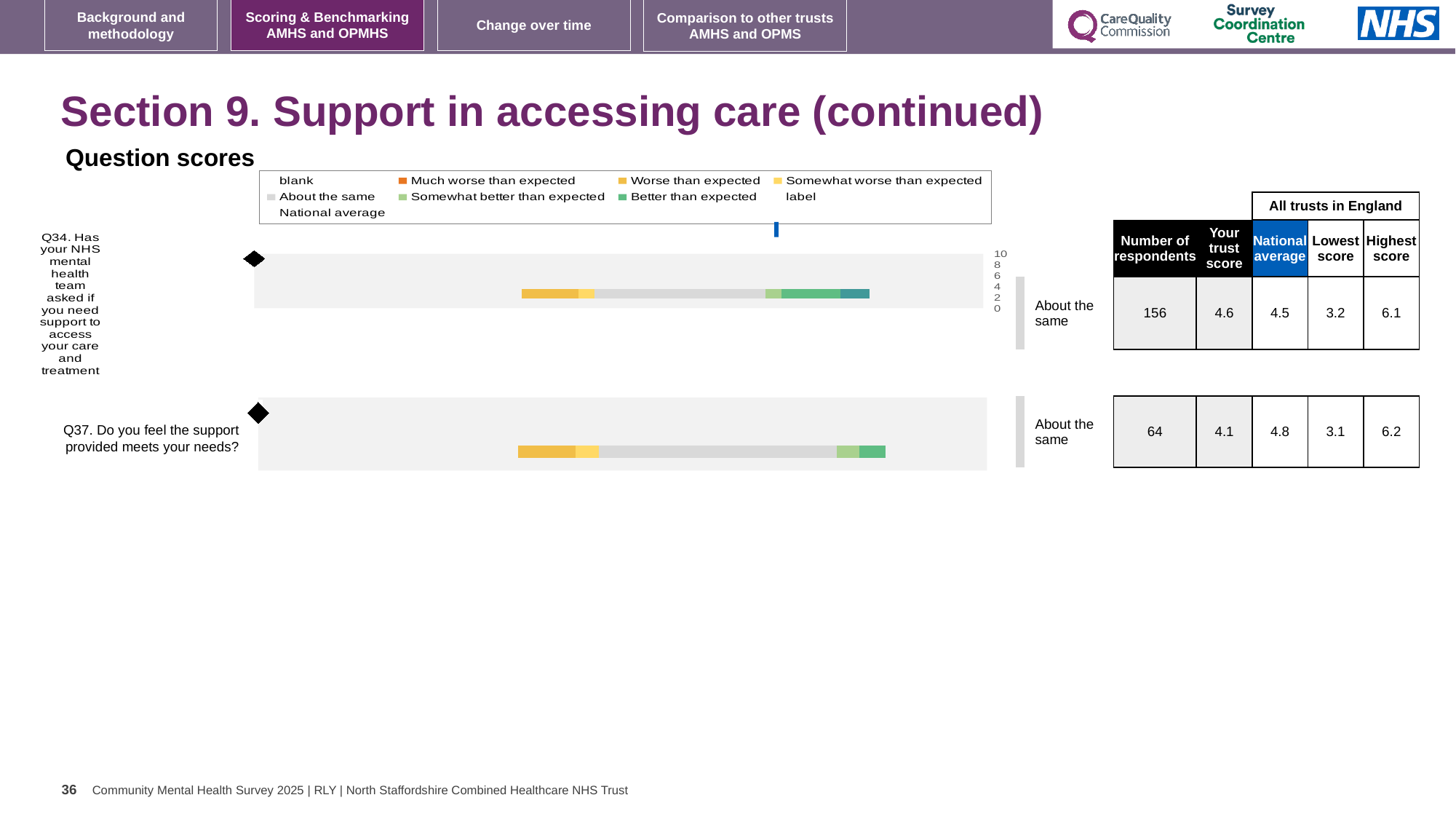
What is the lowest score among all trusts in England for Q34? 3.2 What is the difference between the trust score and the national average for Q37? 0.7 What benchmark category is shown for Q34? About the same How many questions are plotted on the slide? 2 What is the number of respondents for Q34? 156 Which question has the higher trust score, Q34 or Q37? Q34 What is the trust score for Q37 (Do you feel the support provided meets your needs?)? 4.1 What is the difference between the highest and lowest scores for Q34? 2.9 What is the highest score among all trusts in England for Q37? 6.2 Which legend entry is shown in orange? Much worse than expected What kind of chart is used to show the question scores for Q34 and Q37? bar chart What is the national average for Q34? 4.5